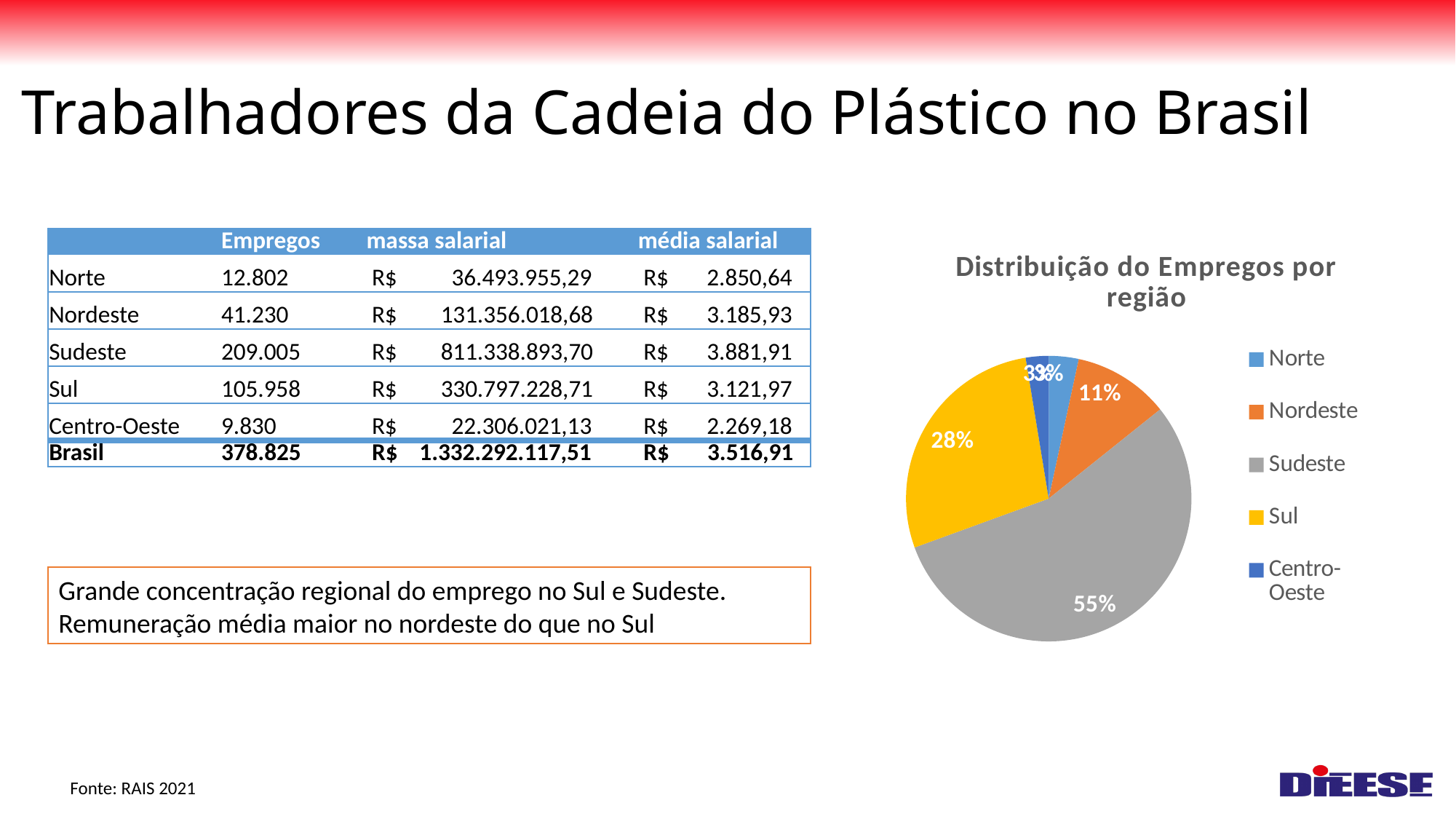
What is the difference in percentage points between the Sul and Nordeste slices? 17% What share of the pie chart does Nordeste hold? 11% What is the difference in percentage points between the Sudeste and Sul slices? 27% What kind of chart is shown on the slide? pie chart What share of the pie chart does Sudeste hold? 55% What share of the pie chart does Sul hold? 28% How many regions does the legend of the pie chart list? 5 What is the title of the pie chart? Distribuição do Empregos por região Which region has the largest slice in the pie chart? Sudeste Which slice is larger in the pie chart, Sul or Nordeste? Sul How many slices does the pie chart have? 5 What colour is the Sul slice in the pie chart? yellow